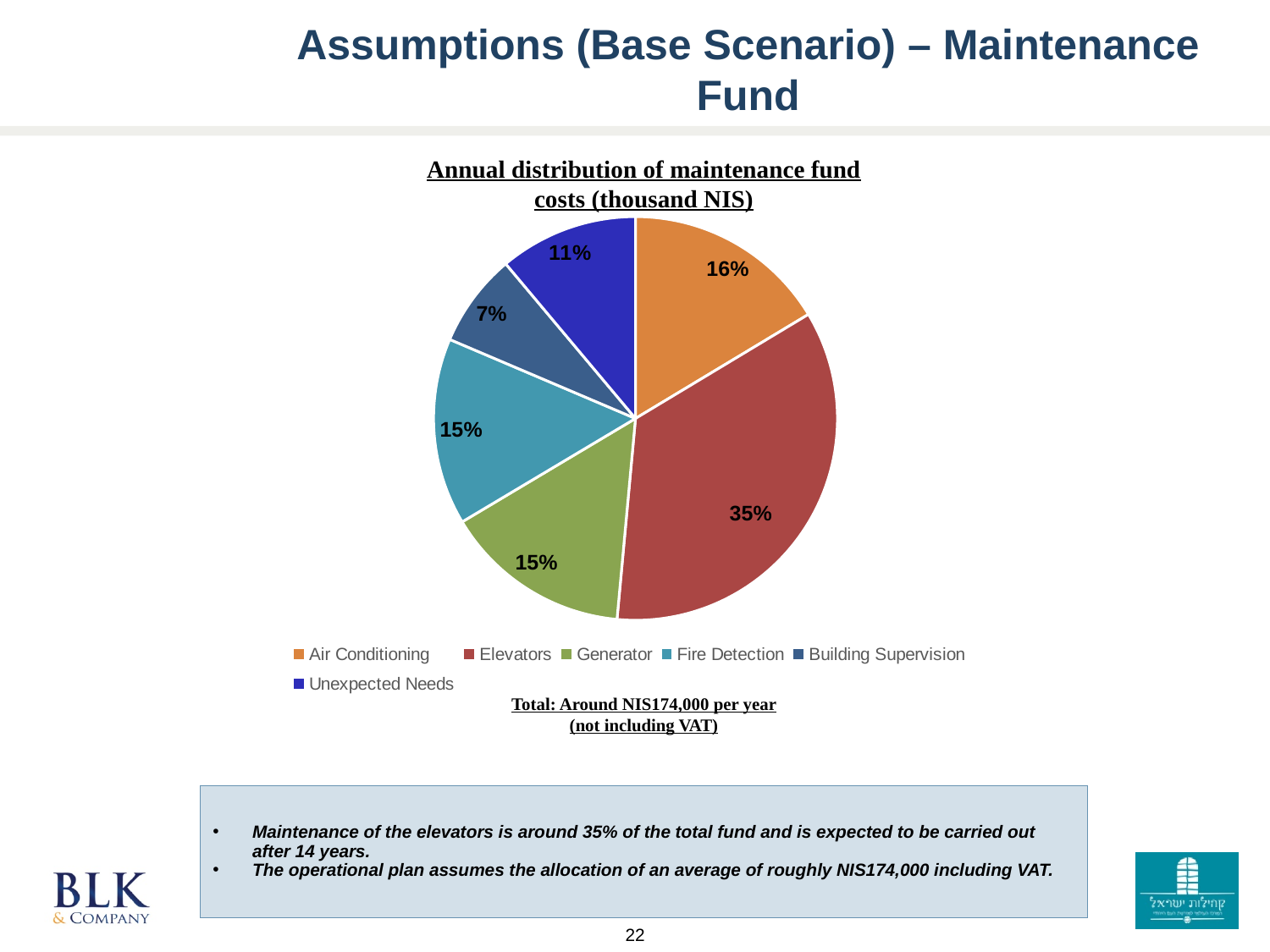
What share of the maintenance fund costs is allocated to Building Supervision? 7% What share of the maintenance fund costs is allocated to Air Conditioning? 16% What share of the maintenance fund costs is allocated to Elevators? 35% What is the difference in percentage points between the Elevators share and the Air Conditioning share? 19 percentage points How many categories does the pie chart show? 6 What is the title of the pie chart? Annual distribution of maintenance fund costs (thousand NIS) Which category has the largest share of the maintenance fund costs? Elevators Which category has the smallest share of the maintenance fund costs? Building Supervision What type of chart is shown on the slide? Pie chart Which has a larger share, Unexpected Needs or Building Supervision? Unexpected Needs